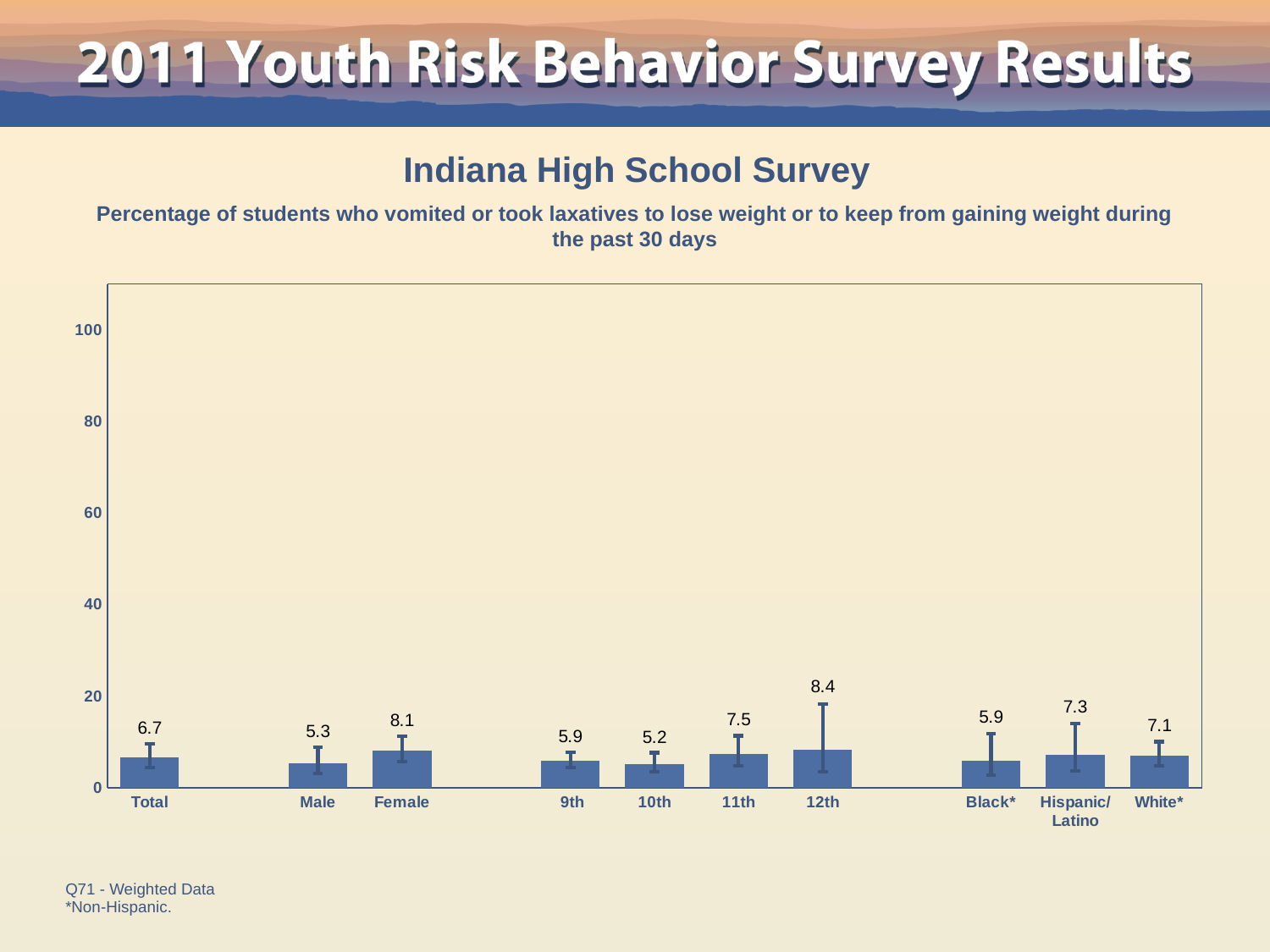
What kind of chart is this? bar chart Which category has the highest value? 12th Which is larger, the value for Black* or the value for White*? White* Which category has the lowest value? 10th What is the value for 12th grade? 8.4 What is the difference between the Female and Male values? 2.8 What is the value for Total? 6.7 Is the value for 12th greater or less than 20? less What is the value for Hispanic/Latino? 7.3 What is the value for Female? 8.1 How many categories are shown on the x axis? 10